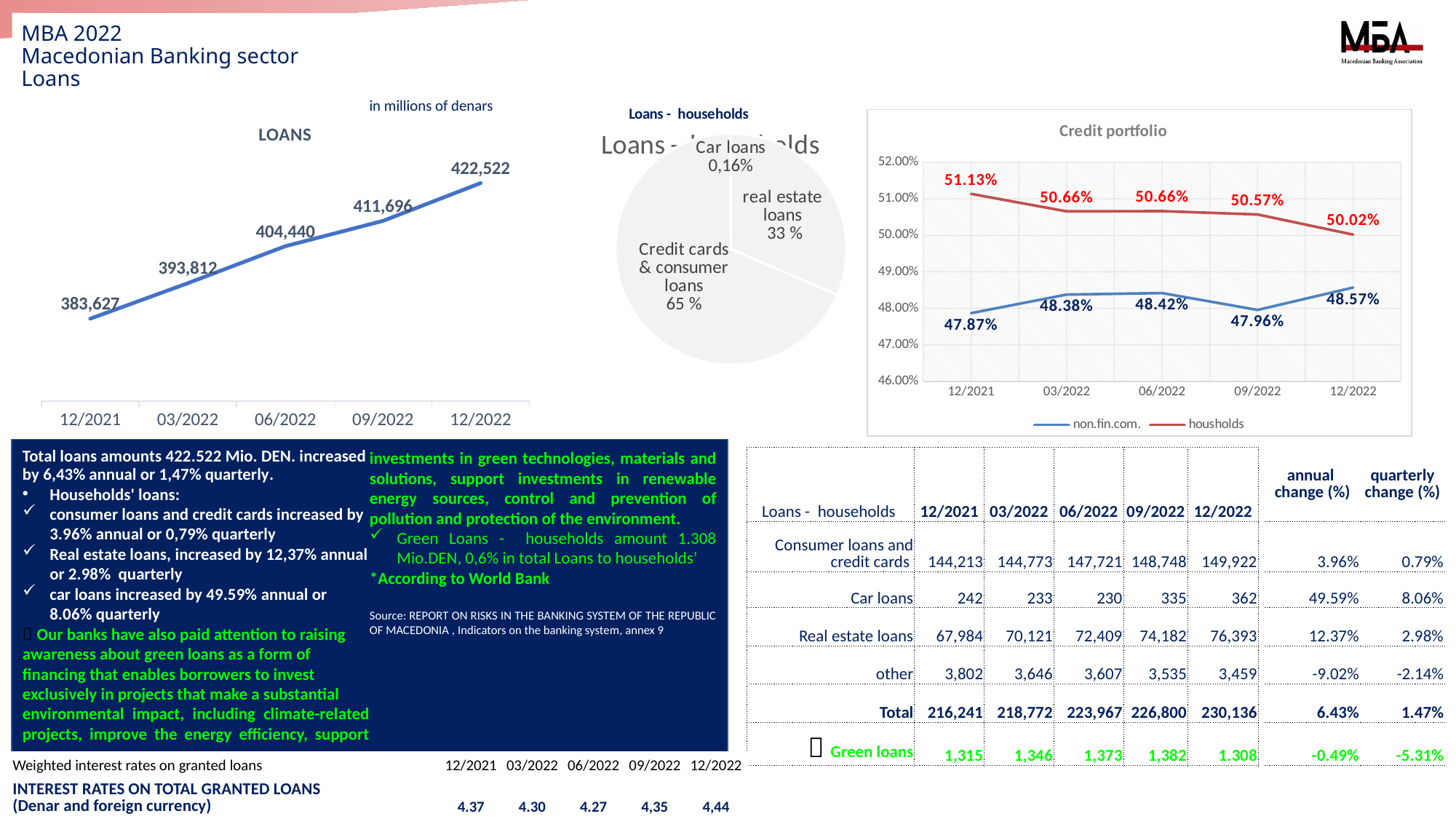
In the Credit portfolio chart, what is the value for housholds at 12/2021? 51.13% How many data points are plotted in the LOANS chart? 5 In the LOANS chart, what is the difference between the 12/2022 value and the 12/2021 value? 38,895 In the Credit portfolio chart, which series has the higher value at 12/2022, non.fin.com. or housholds? housholds In the Credit portfolio chart, what is the value for non.fin.com. at 09/2022? 47.96% In the LOANS chart, what is the value for 12/2021? 383,627 In the LOANS chart, do the values rise or fall from 12/2021 to 12/2022? rise In the Loans - households pie chart, which slice is the smallest? Car loans In the Loans - households pie chart, what share do real estate loans have? 33 % In the LOANS chart, what is the value for 12/2022? 422,522 How many slices does the Loans - households pie chart have? 3 How many series does the legend of the Credit portfolio chart list? 2